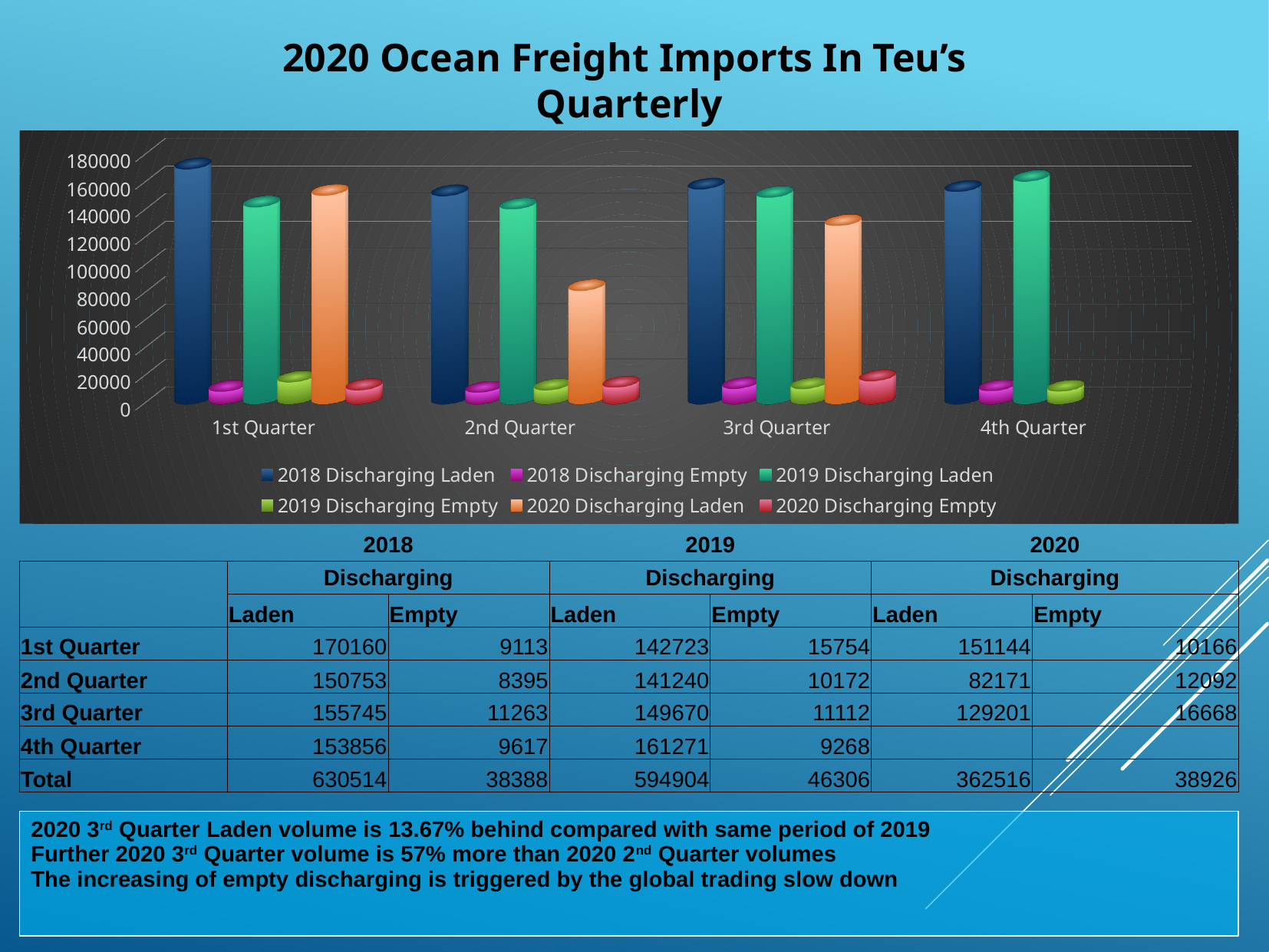
In which quarter is the 2020 Discharging Laden value lowest? 2nd Quarter Which is larger for the 1st Quarter: 2018 Discharging Laden or 2019 Discharging Laden? 2018 Discharging Laden What kind of chart is shown on the slide? Bar chart What is the difference between the 2020 Discharging Laden and 2019 Discharging Laden values for the 1st Quarter? 8421 What is the 2018 Discharging Laden value for the 1st Quarter? 170160 What is the 2020 Discharging Laden value for the 2nd Quarter? 82171 What colour represents 2020 Discharging Laden in the chart legend? Orange In which quarter is the 2019 Discharging Laden value highest? 4th Quarter What is the 2019 Discharging Empty value for the 3rd Quarter? 11112 Is the 2020 Discharging Laden value for the 2nd Quarter greater or less than 100000? less How many series does the chart legend list? 6 How many quarters are shown on the x axis of the chart? 4